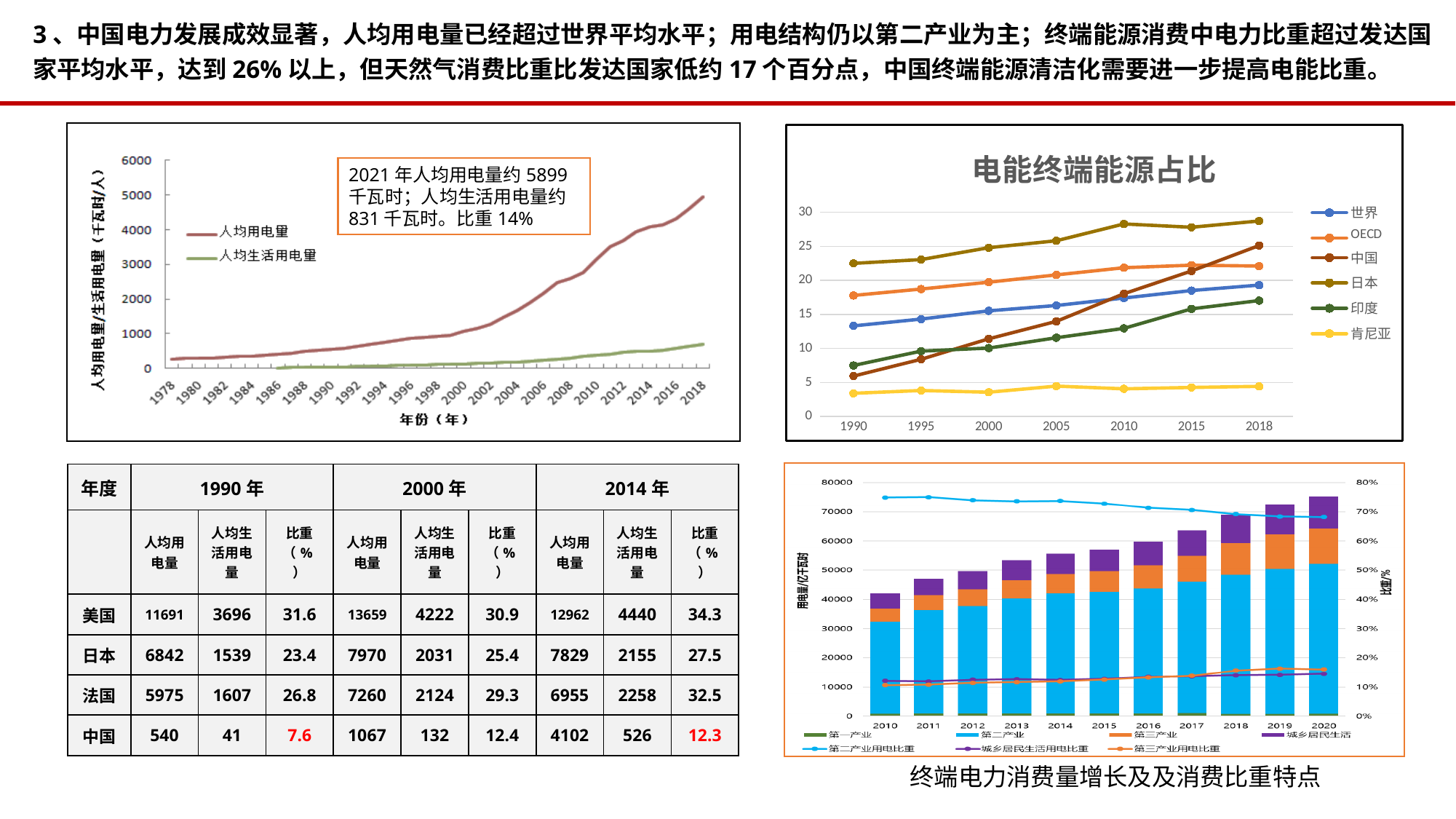
In the top-left chart, is the value of 人均用电量 in 2018 greater or less than 4000? greater In the chart titled 电能终端能源占比, which is larger in 2018, 中国 or OECD? 中国 How many years are shown on the x axis of the chart titled 电能终端能源占比? 7 In the bottom-right chart titled 终端电力消费量增长及及消费比重特点, how many years are shown on the x axis? 11 How many series does the legend of the top-left chart list? 2 In the chart titled 电能终端能源占比, is the value for 中国 in 1990 greater or less than 10? less In the top-left chart, does 人均用电量 rise or fall from 1978 to 2018? rise How many series does the legend of the chart titled 电能终端能源占比 list? 6 In the bottom-right chart titled 终端电力消费量增长及及消费比重特点, does the 第二产业用电比重 line rise or fall from 2010 to 2020? fall What kind of chart is the top-left chart showing 人均用电量 and 人均生活用电量? line chart In the chart titled 电能终端能源占比, which series has the highest value in 2018? 日本 In the chart titled 电能终端能源占比, which series has the lowest value in 2018? 肯尼亚